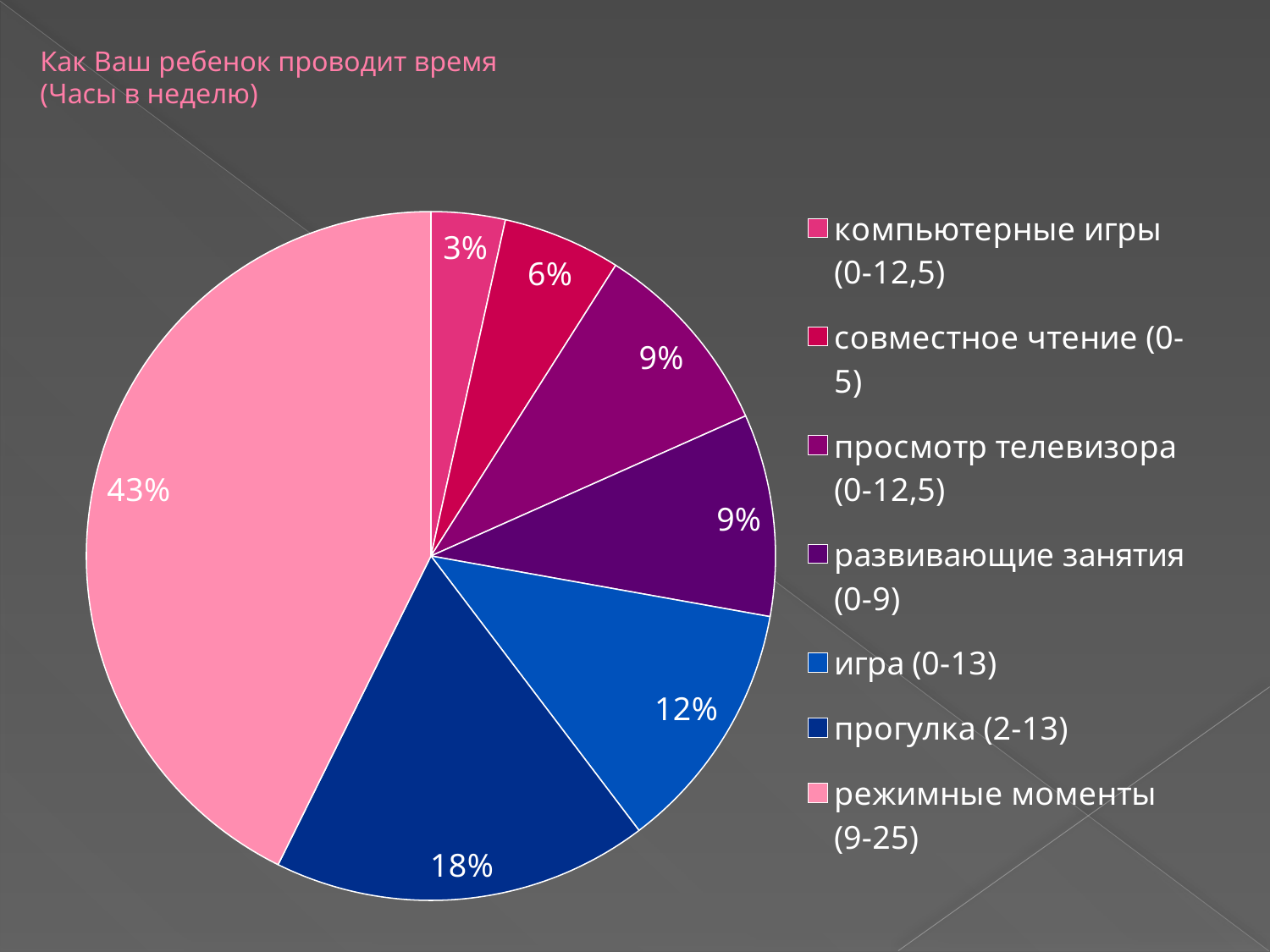
What is the value shown for "игра (0-13)"? 12% What share of the pie does "режимные моменты (9-25)" take? 43% How many categories does the pie chart have? 7 What is the title of the chart? Как Ваш ребенок проводит время (Часы в неделю) Which category has the largest slice of the pie? режимные моменты (9-25) What is the value shown for "компьютерные игры (0-12,5)"? 3% What type of chart is shown on the slide? pie chart Which is larger, the share for "совместное чтение (0-5)" or the share for "просмотр телевизора (0-12,5)"? просмотр телевизора (0-12,5) What is the value shown for "прогулка (2-13)"? 18% What is the value shown for "совместное чтение (0-5)"? 6% What is the difference between the shares of "прогулка (2-13)" and "игра (0-13)"? 6% Which category has the smallest slice of the pie? компьютерные игры (0-12,5)